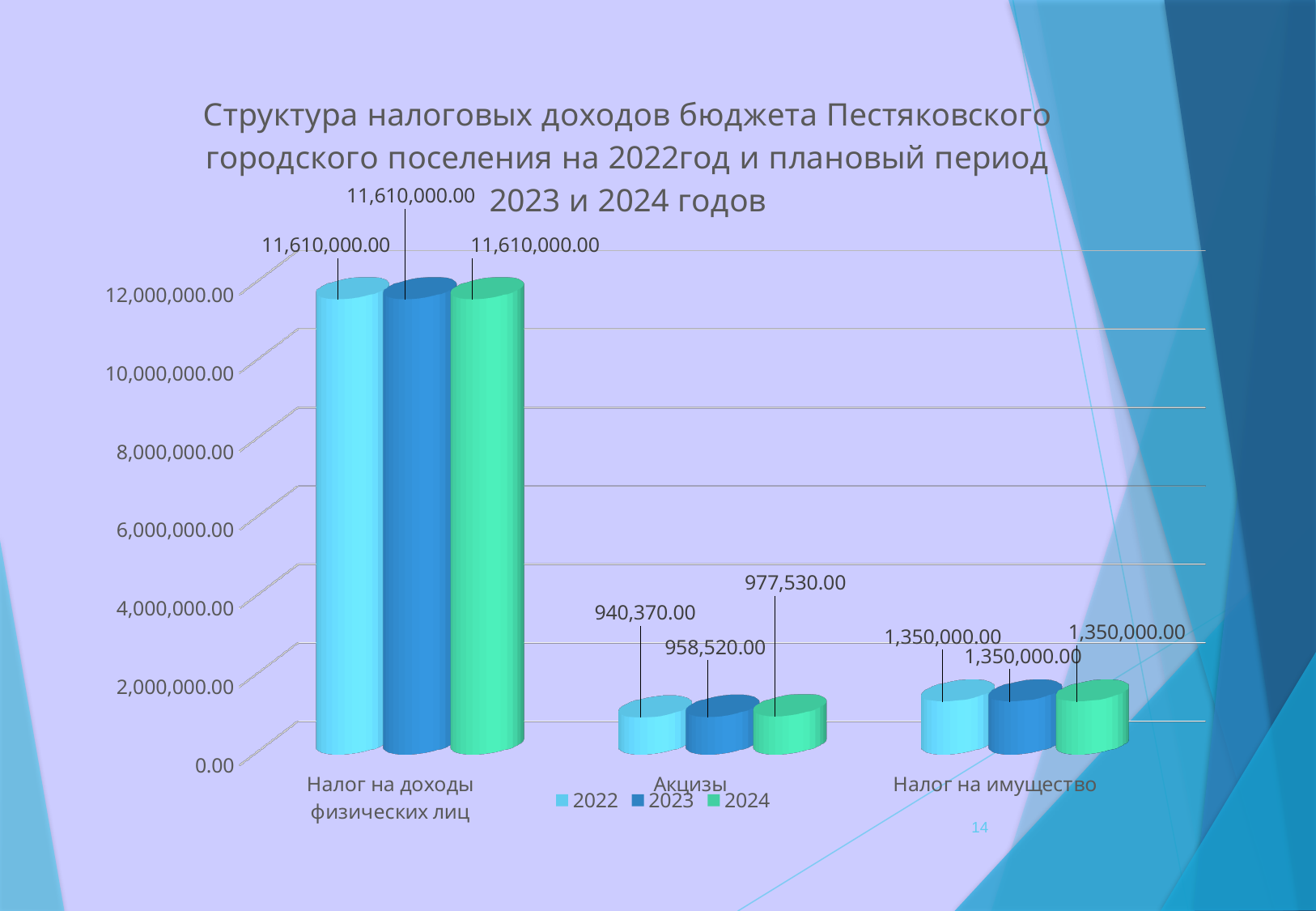
How many categories are shown on the x axis? 3 What is the difference between the 2024 and 2022 values for Акцизы? 37,160.00 What is the value for Акцизы in 2022? 940,370.00 What is the value for Налог на имущество in 2024? 1,350,000.00 What is the value for Акцизы in 2024? 977,530.00 Which category has the lowest values across all years? Акцизы What is the value for Налог на доходы физических лиц in 2023? 11,610,000.00 Is the value for Налог на доходы физических лиц in 2022 greater or less than 10,000,000.00? greater Which is larger: the 2023 value for Акцизы or the 2023 value for Налог на имущество? Налог на имущество Which category has the highest values across all years? Налог на доходы физических лиц Do the values for Акцизы rise or fall from 2022 to 2024? rise How many series does the legend list? 3